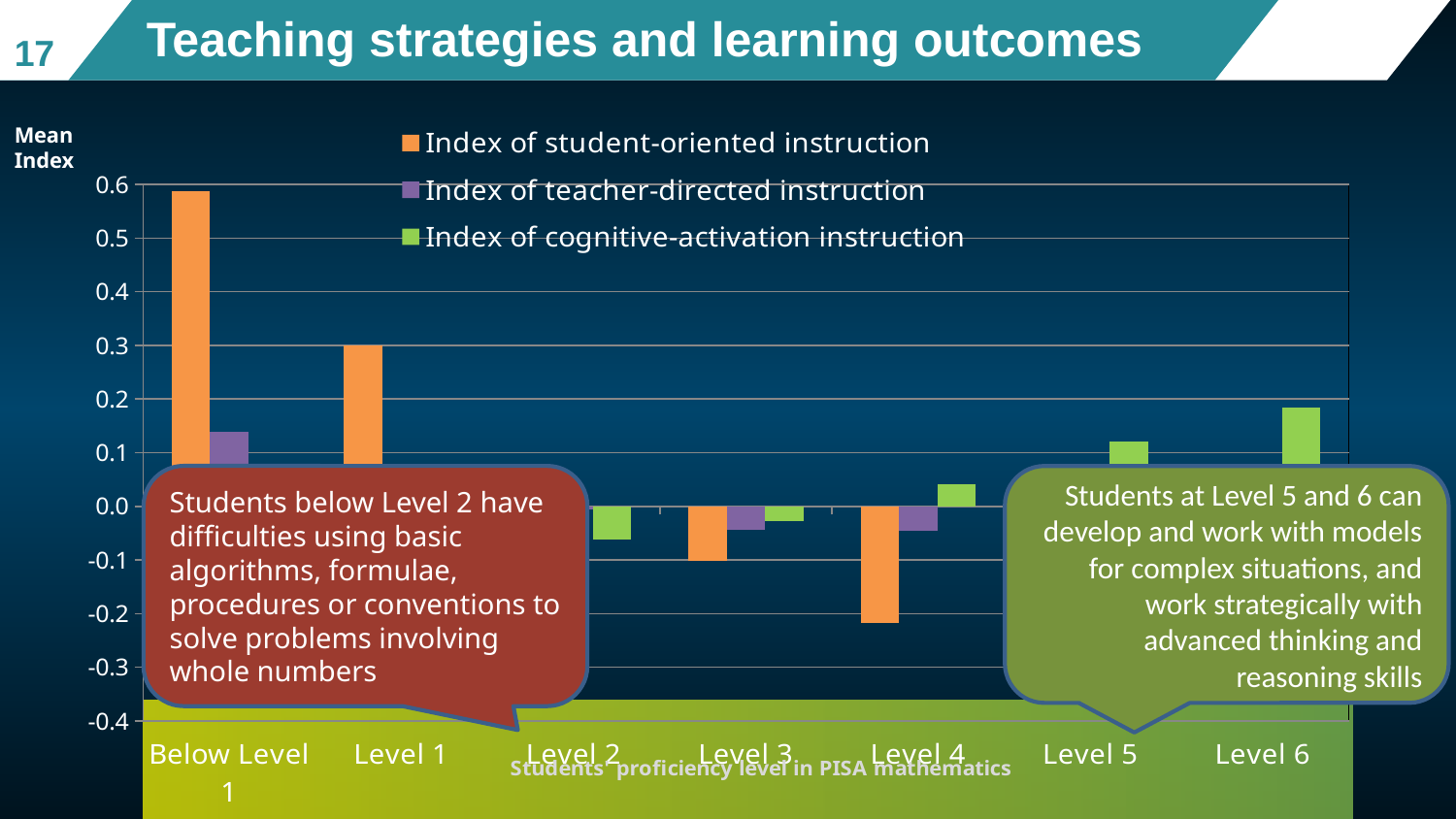
Is the value of the Index of student-oriented instruction for Level 4 greater or less than -0.1? less How many proficiency-level categories are shown on the x axis? 7 Which proficiency level has the highest value for the Index of cognitive-activation instruction? Level 6 Which proficiency level has the highest value for the Index of student-oriented instruction? Below Level 1 Is the value of the Index of cognitive-activation instruction for Level 6 greater or less than 0.1? greater Is the value of the Index of student-oriented instruction for Level 1 greater or less than 0.2? greater Does the Index of cognitive-activation instruction rise or fall from Level 2 to Level 6? rise How many series does the legend list? 3 What is the title of the x axis? Students' proficiency level in PISA mathematics What kind of chart is shown on the slide? Bar chart For the Index of cognitive-activation instruction, which is larger: Level 5 or Level 6? Level 6